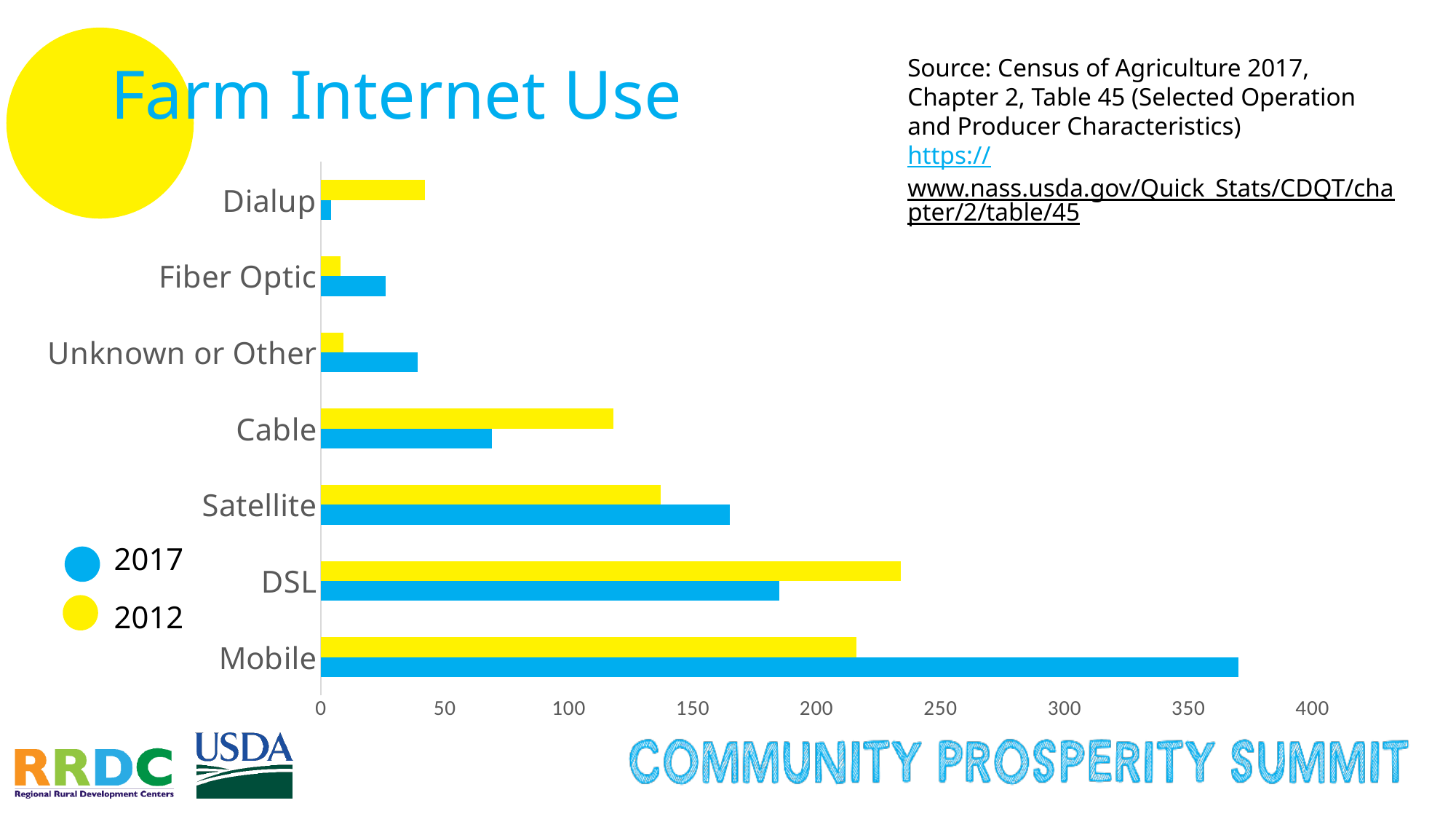
Which category has the lowest value for 2017? Dialup What kind of chart is shown on the slide? bar chart Which colour represents the 2012 series in the legend? yellow Is the 2017 value for Mobile greater or less than 350? greater How many categories of internet access are shown on the chart? 7 Which category has the highest value for 2012? DSL Which category has the highest value for 2017? Mobile How many series does the legend list? 2 Is the 2017 value for Cable greater or less than 100? less For Satellite, which year has the larger value, 2017 or 2012? 2017 Is the 2012 value for DSL greater or less than 200? greater For Dialup, which year has the larger value, 2017 or 2012? 2012